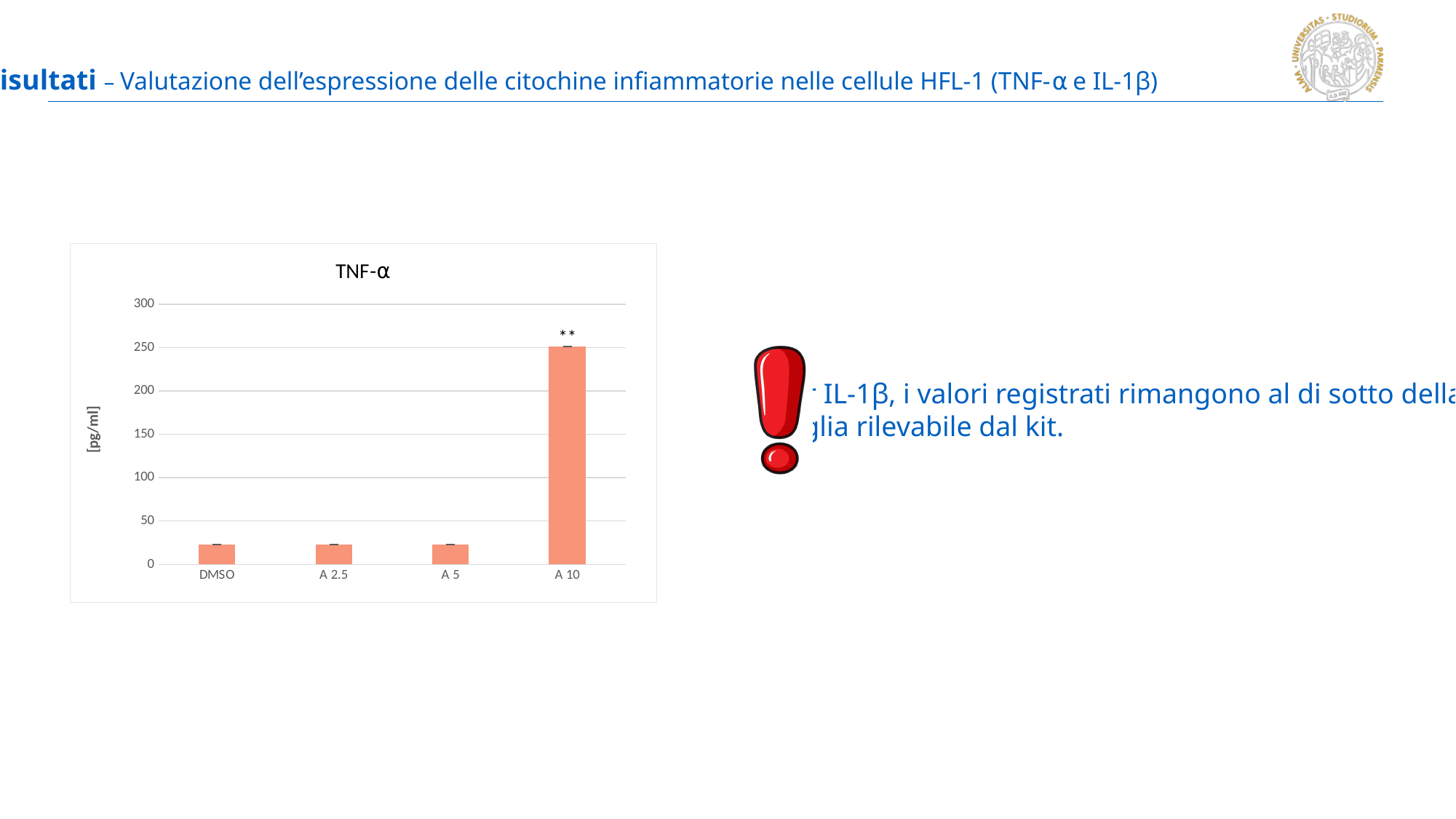
Which is larger, the value for A 10 or the value for DMSO? A 10 What is the label on the vertical axis of the chart? [pg/ml] Which category has the highest value in the chart? A 10 Is the value for A 2.5 greater or less than 50? less How many categories are plotted on the x axis of the chart? 4 Which is larger, the value for A 5 or the value for A 10? A 10 Is the value for DMSO greater or less than 50? less What is the highest tick value shown on the vertical axis of the chart? 300 Is the value for A 5 greater or less than 100? less What is the title of the chart? TNF-α What kind of chart is shown on the slide? bar chart